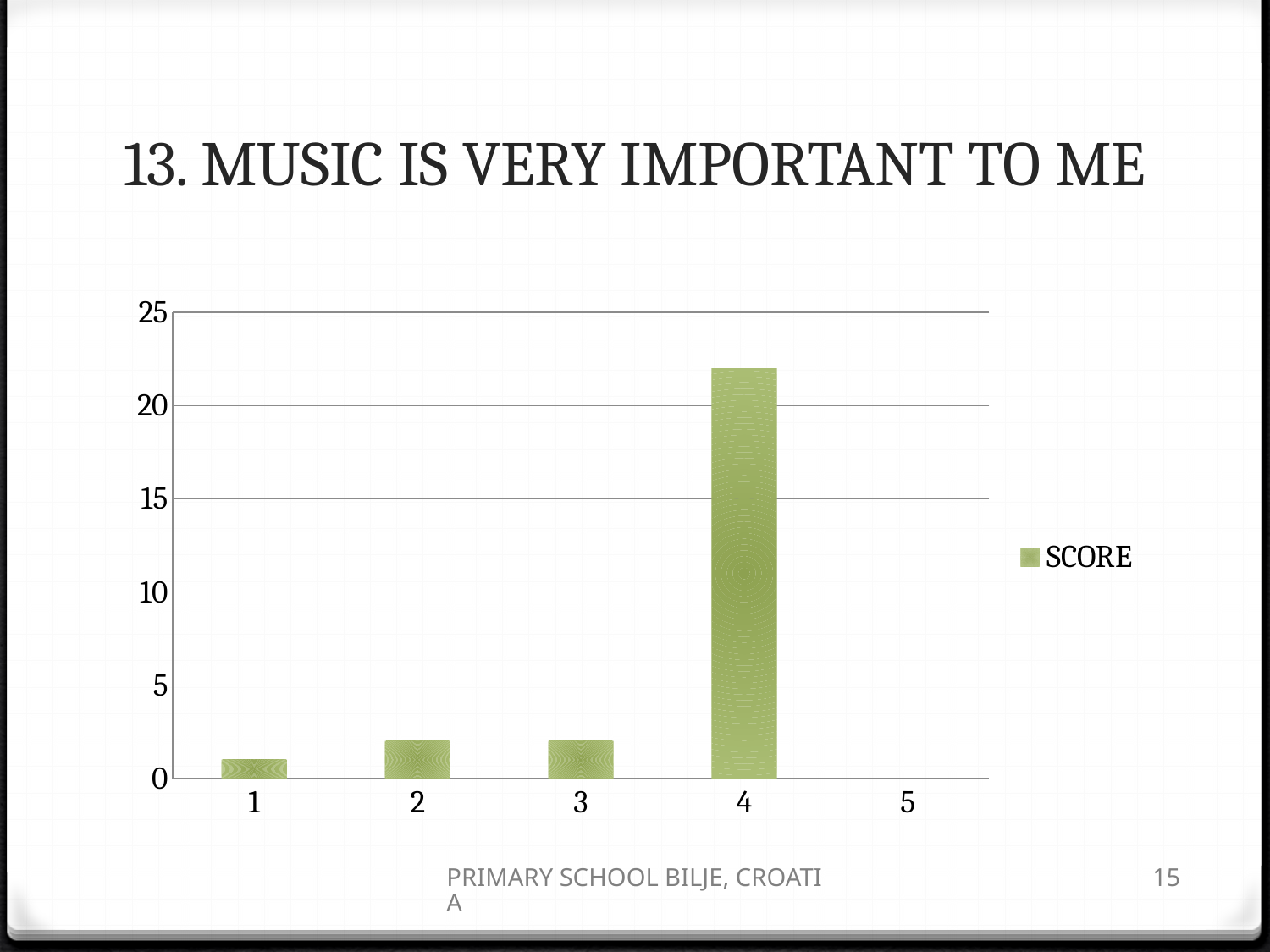
Is the SCORE for category 4 greater or less than 20? greater Which category has the highest SCORE? 4 What is the name of the series shown in the legend? SCORE How many series does the legend list? 1 Which category has the lowest SCORE? 5 Which has the larger SCORE, category 1 or category 4? 4 Is the SCORE for category 4 greater or less than 25? less What is the title of the chart on the slide? 13. MUSIC IS VERY IMPORTANT TO ME Is the SCORE for category 1 greater or less than 5? less What kind of chart is shown on the slide? bar chart How many categories are shown on the x axis? 5